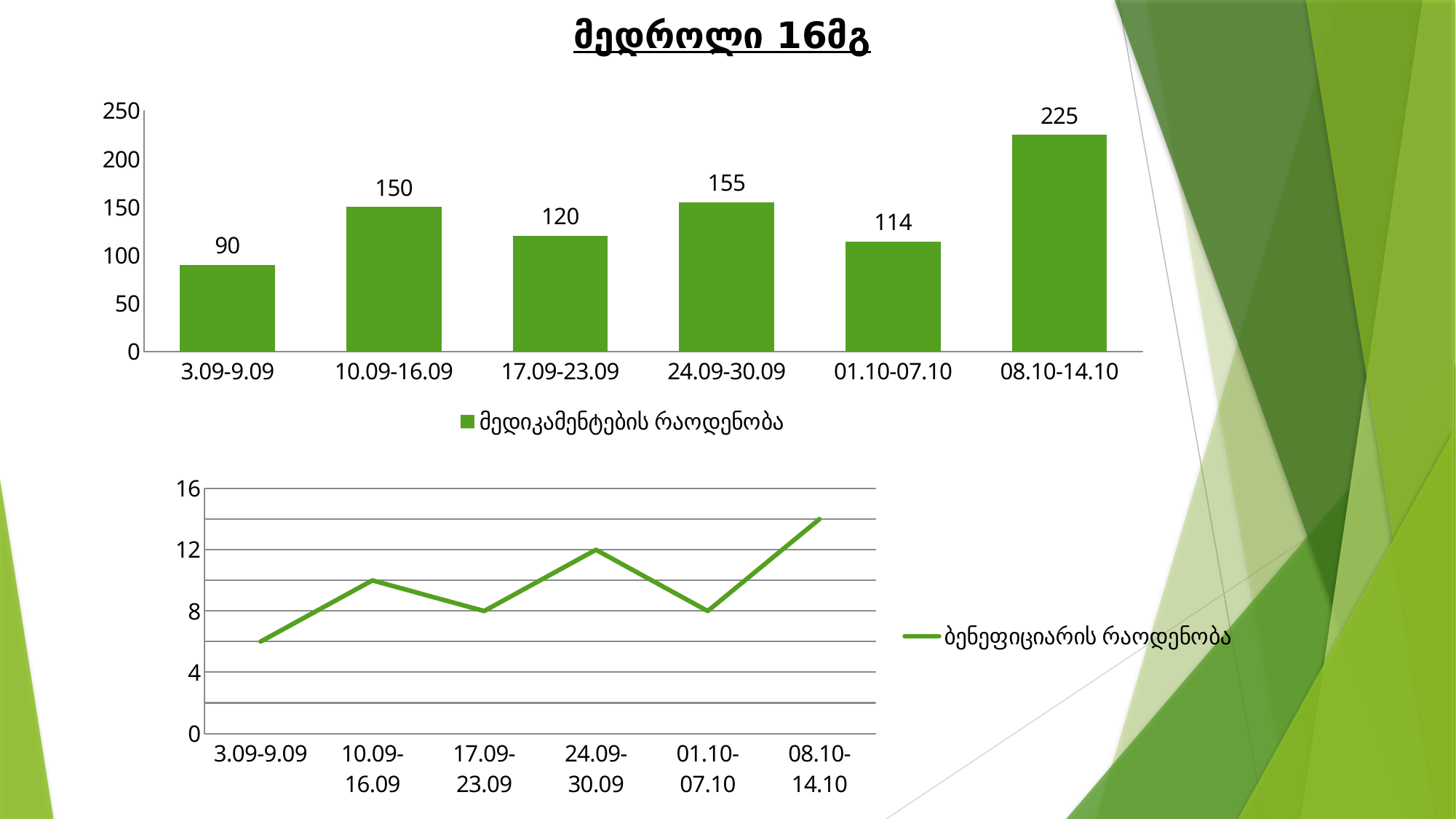
In the top bar chart, which period has the highest value? 08.10-14.10 How many periods are shown in the top bar chart? 6 In the top bar chart, what is the difference between the values for 08.10-14.10 and 3.09-9.09? 135 In the bottom line chart, is the value for 3.09-9.09 greater or less than 8? less In the top bar chart, what is the value for 01.10-07.10? 114 In the top bar chart, which is larger, the value for 10.09-16.09 or 24.09-30.09? 24.09-30.09 In the top bar chart, what is the value for 08.10-14.10? 225 What kind of chart is the top chart on the slide? Bar chart In the bottom line chart, is the value for 08.10-14.10 greater or less than 12? greater What kind of chart is the bottom chart on the slide? Line chart In the bottom line chart, which period has the highest value? 08.10-14.10 In the top bar chart, which period has the lowest value? 3.09-9.09